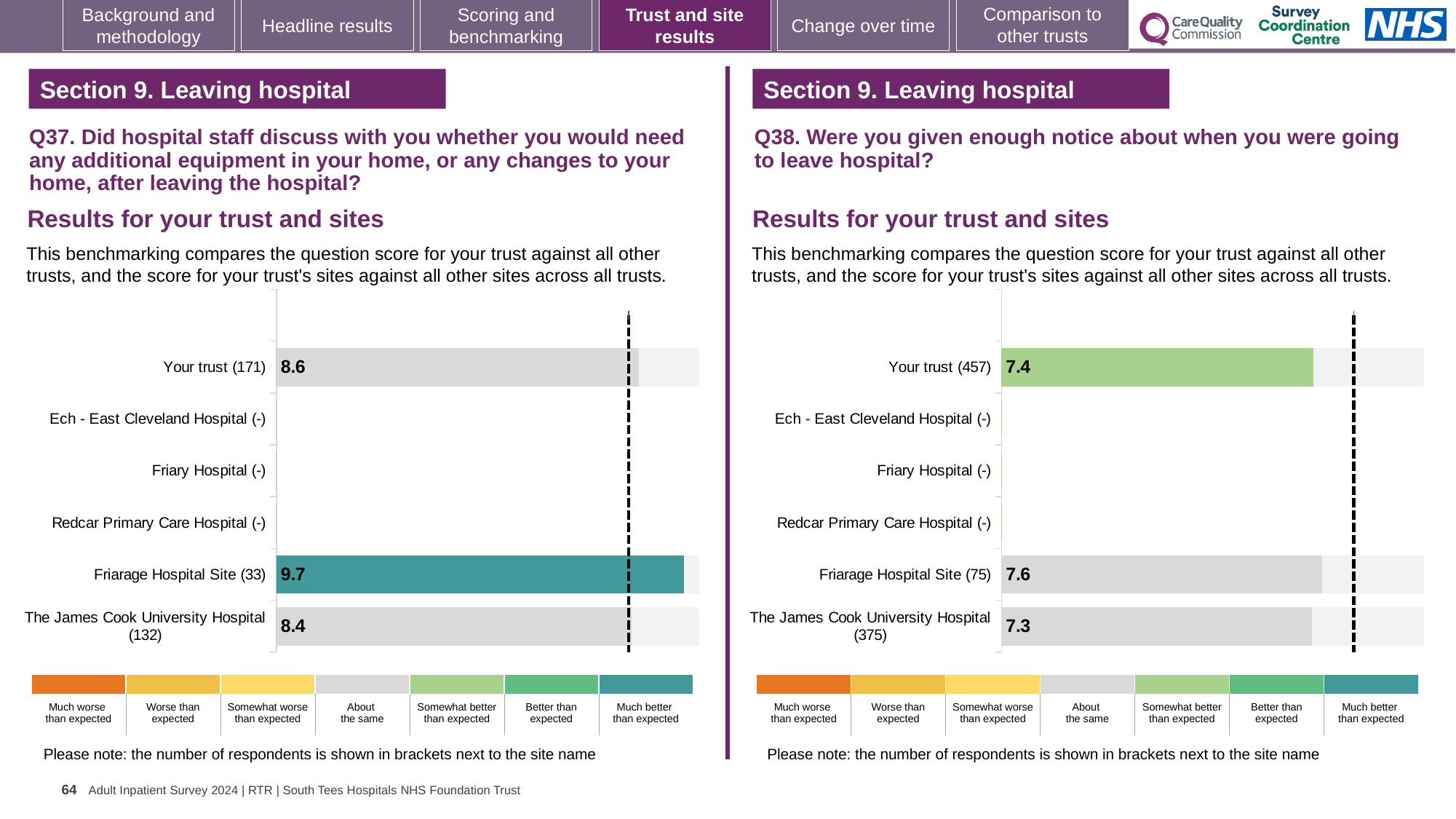
In the Q38 chart on the right, which of the two sites with a score has the lower score? The James Cook University Hospital (375) In the Q38 chart on the right, what is the difference between the Friarage Hospital Site score and the Your trust score? 0.2 In the Q38 chart on the right, what is the score for Your trust (457)? 7.4 In the Q37 chart on the left, what is the score for Friarage Hospital Site (33)? 9.7 In the Q37 chart on the left, how many categories are listed on the vertical axis? 6 What kind of chart is used in the Q37 chart on the left? Bar chart In the Q38 chart on the right, what is the score for The James Cook University Hospital (375)? 7.3 In the Q38 chart on the right, what is the score for Friarage Hospital Site (75)? 7.6 In the Q37 chart on the left, which site has the highest score? Friarage Hospital Site (33) In the Q37 chart on the left, what is the score for The James Cook University Hospital (132)? 8.4 In the Q37 chart on the left, what is the score for Your trust (171)? 8.6 In the Q37 chart on the left, what is the difference between the Friarage Hospital Site score and The James Cook University Hospital score? 1.3